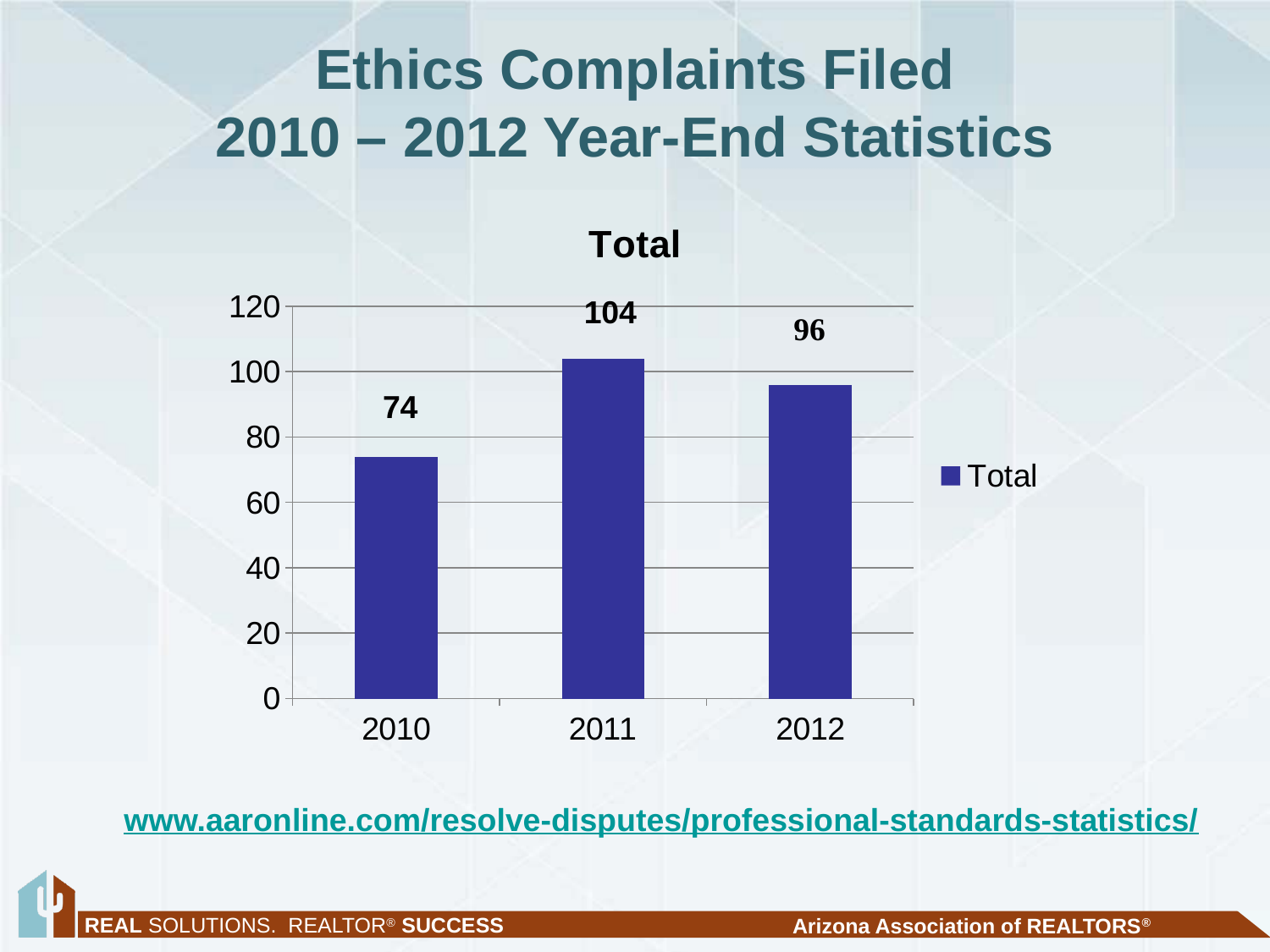
What is the value for 2012? 96 Which year has the highest value? 2011 What is the difference between the values for 2011 and 2012? 8 Which is larger, the value for 2012 or the value for 2010? 2012 What kind of chart is shown? bar chart What is the value for 2010? 74 How many years are shown on the x axis? 3 What is the title of the chart? Total Which year has the lowest value? 2010 What is the difference between the values for 2011 and 2010? 30 What is the value for 2011? 104 Is the value for 2011 greater or less than 100? greater